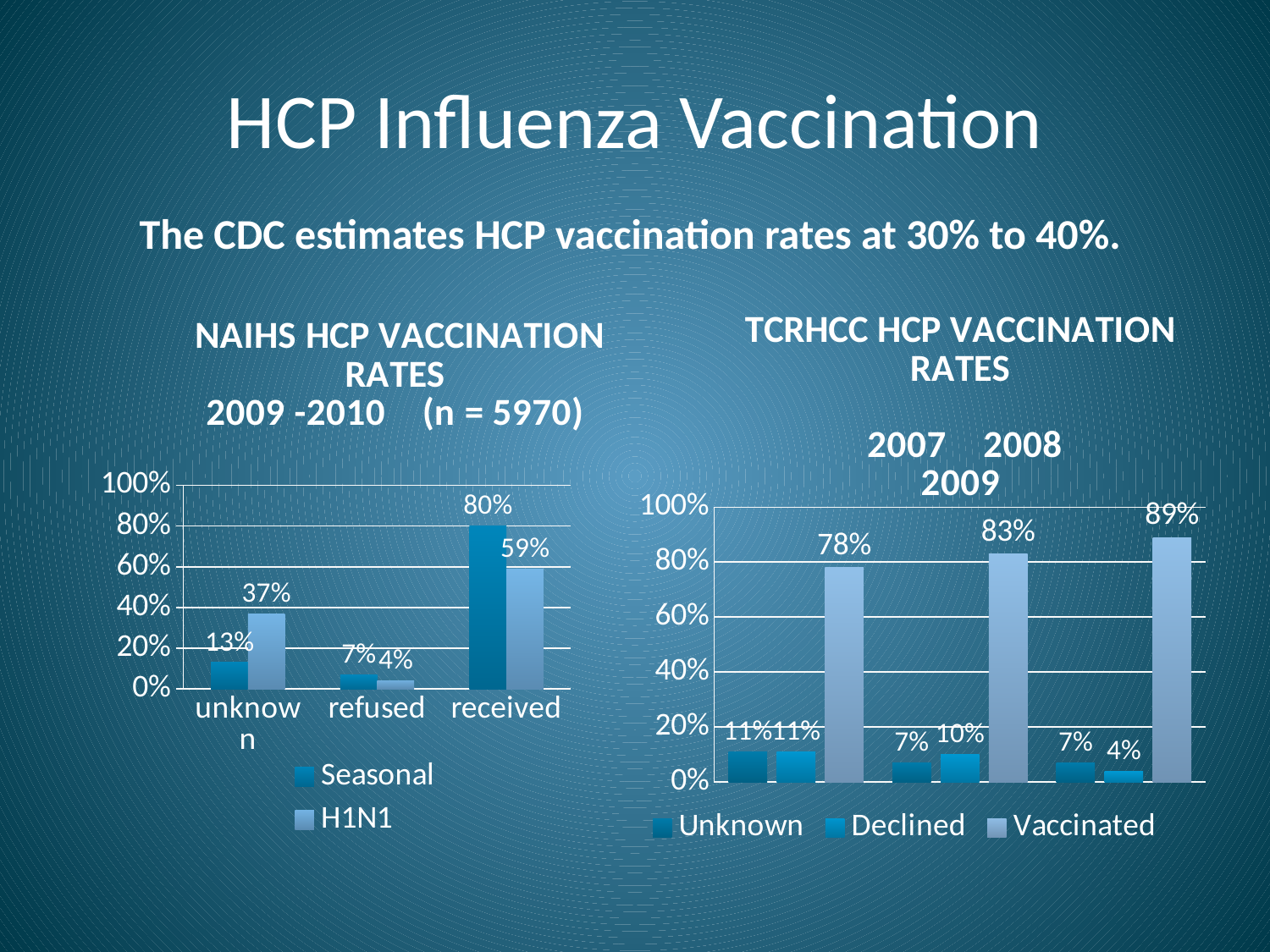
In the TCRHCC HCP Vaccination Rates chart, what is the difference between the Vaccinated values in the third and first groups of bars? 11% How many series does the legend of the TCRHCC HCP Vaccination Rates chart list? 3 In the TCRHCC HCP Vaccination Rates chart, does the Vaccinated value rise or fall from the first group to the third group? rise In the NAIHS HCP Vaccination Rates chart, what is the Seasonal value for received? 80% In the NAIHS HCP Vaccination Rates chart, which category has the lowest H1N1 value? refused How many series does the legend of the NAIHS HCP Vaccination Rates chart list? 2 In the TCRHCC HCP Vaccination Rates chart, what is the Declined value in the first group of bars? 11% In the NAIHS HCP Vaccination Rates chart, what is the H1N1 value for unknown? 37% What type of chart is the NAIHS HCP Vaccination Rates chart? bar chart In the TCRHCC HCP Vaccination Rates chart, what is the Vaccinated value in the third group of bars? 89% In the NAIHS HCP Vaccination Rates chart, what is the difference between the Seasonal and H1N1 values for received? 21% In the NAIHS HCP Vaccination Rates chart, which is larger for unknown: Seasonal or H1N1? H1N1